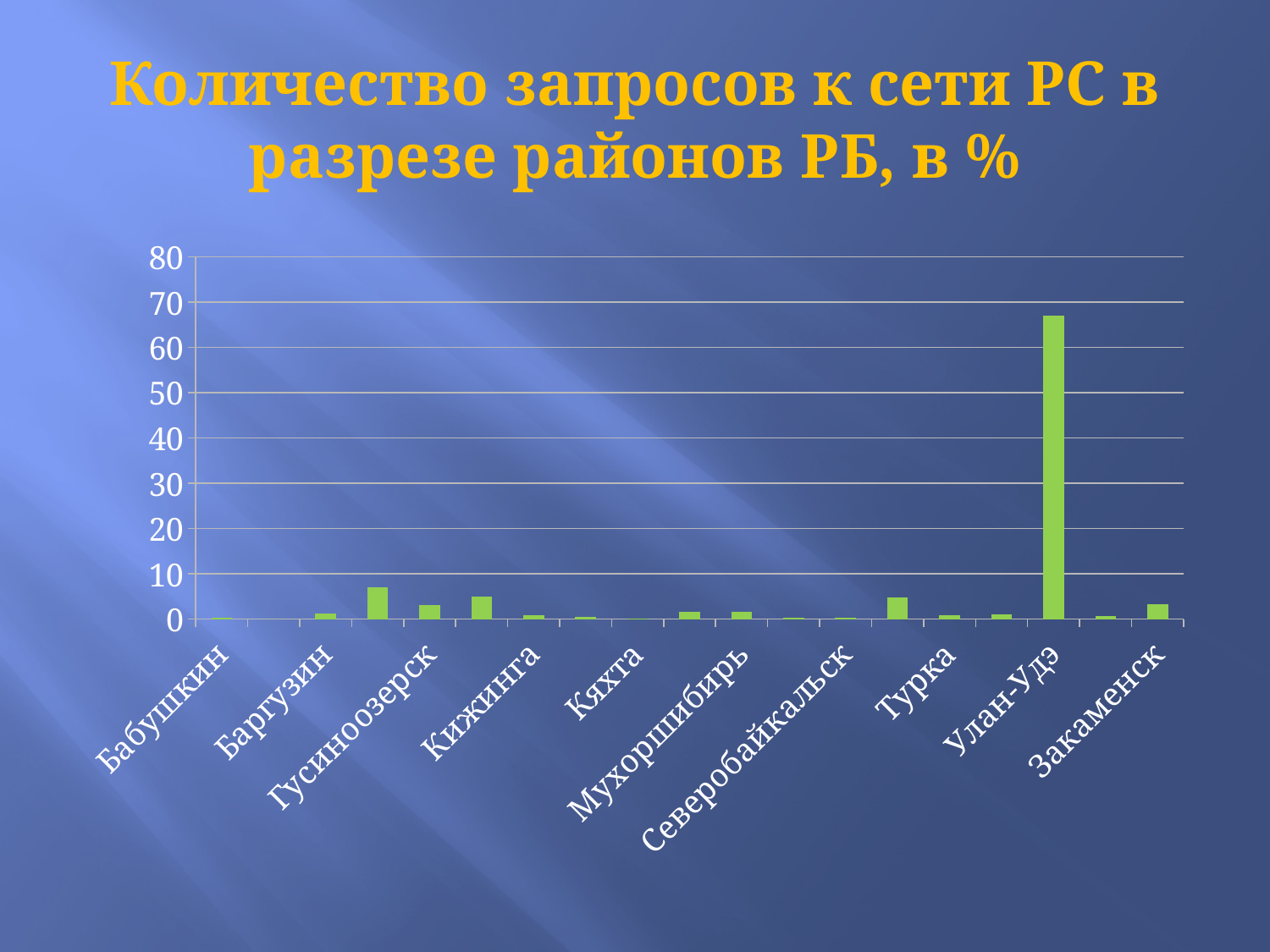
What is the title of the chart on the slide? Количество запросов к сети РС в разрезе районов РБ, в % What is the highest value shown on the vertical axis? 80 Is the value for Улан-Удэ greater or less than 70? less What kind of chart is shown on the slide? bar chart Is the value for Улан-Удэ greater or less than 60? greater Which district has the highest value in the chart? Улан-Удэ Is the value for Гусиноозерск greater or less than 10? less What colour are the bars in the chart? green Which is larger, the value for Закаменск or the value for Турка? Закаменск Which is larger, the value for Улан-Удэ or the value for Гусиноозерск? Улан-Удэ Which is larger, the value for Гусиноозерск or the value for Кижинга? Гусиноозерск